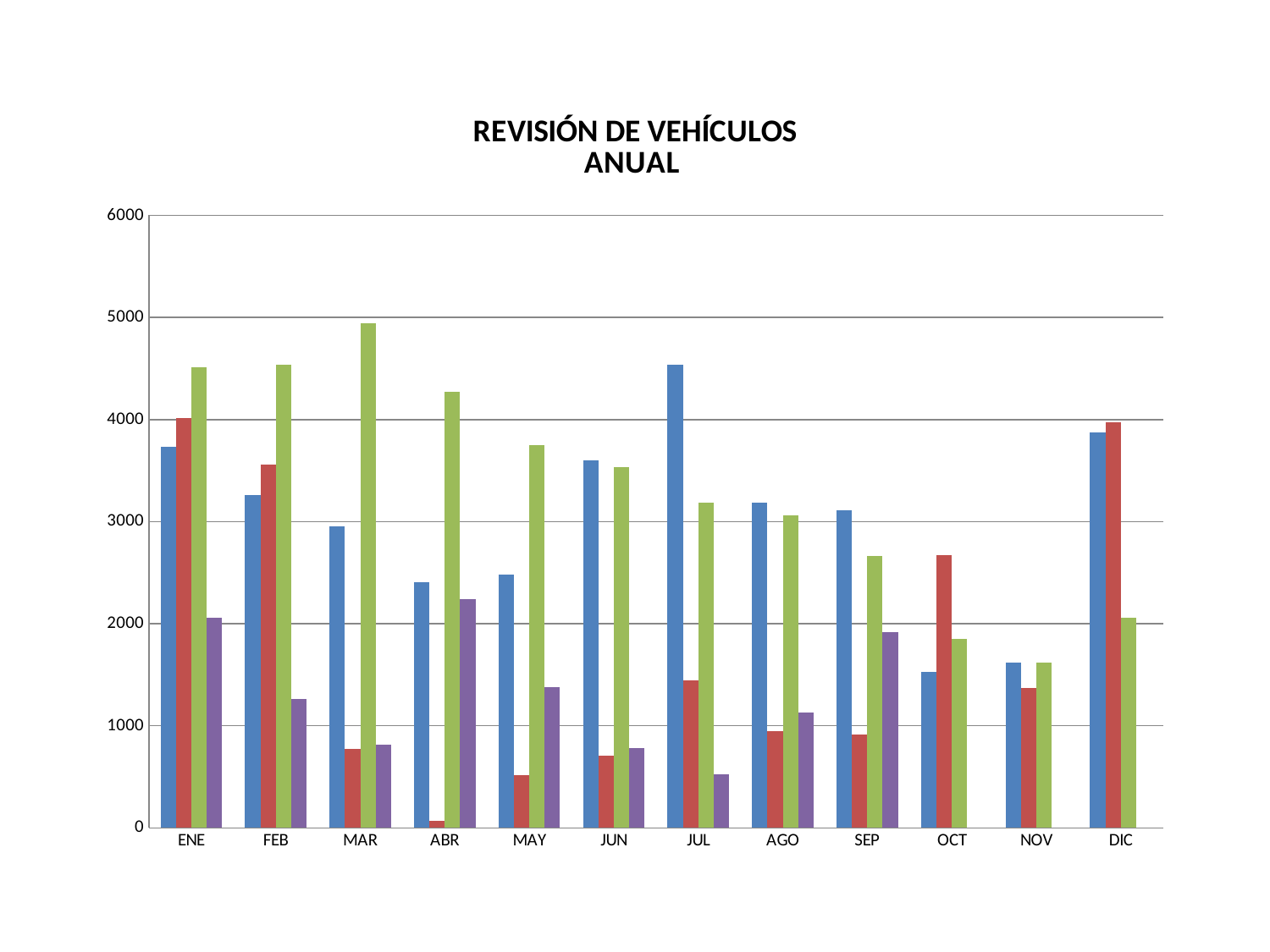
In which month is the green bar the highest? MAR What is the title of the chart? REVISIÓN DE VEHÍCULOS ANUAL In ENE, which bar is larger, the blue bar or the green bar? green Is the value of the red bar for OCT greater or less than 2000? greater Is the value of the blue bar for NOV greater or less than 2000? less In OCT, which bar is larger, the blue bar or the red bar? red How many months (categories) are shown on the x axis? 12 In which month is the red bar the lowest? ABR Is the value of the purple bar for ABR greater or less than 3000? less In which month is the blue bar the highest? JUL What kind of chart is shown on the slide? bar chart